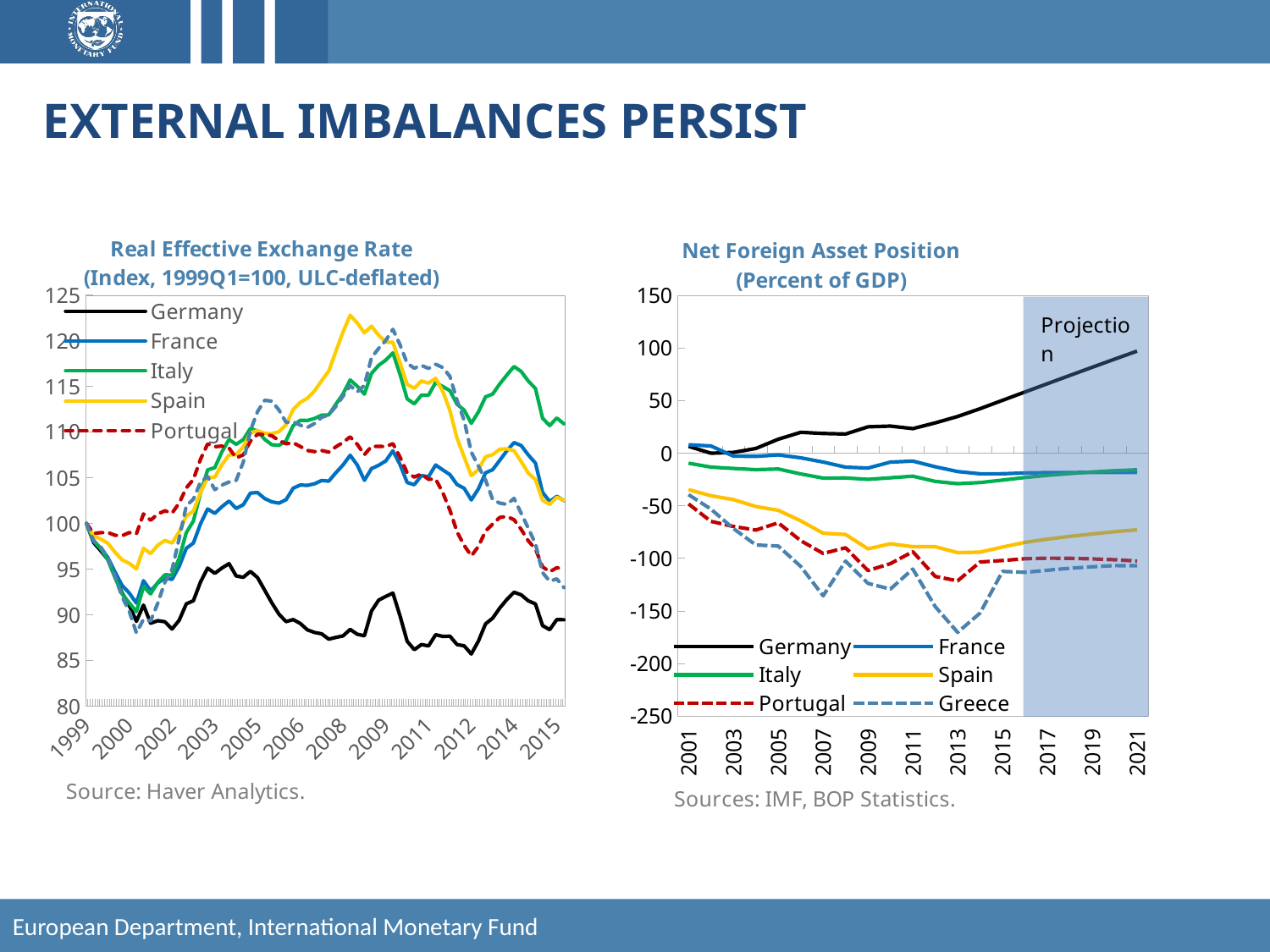
In the Real Effective Exchange Rate chart, which country has the lowest value in 2015? Germany How many series does the legend of the Net Foreign Asset Position chart list? 6 In the Net Foreign Asset Position chart, which country has the lowest value in 2013? Greece In the Net Foreign Asset Position chart, which country has the highest value in 2021? Germany In the Net Foreign Asset Position chart, which is larger in 2021, Spain or Portugal? Spain What kind of chart is the Real Effective Exchange Rate chart on the left? line chart How many series does the legend of the Real Effective Exchange Rate chart list? 5 In the Net Foreign Asset Position chart, is the value for Germany in 2021 greater or less than 50? greater In the Net Foreign Asset Position chart, does Germany's line rise or fall from 2001 to 2021? rise What does the shaded area on the right of the Net Foreign Asset Position chart indicate? Projection In the Real Effective Exchange Rate chart, is the value for Spain in 2008 greater or less than 120? greater In the Net Foreign Asset Position chart, is the value for Greece in 2013 greater or less than -150? less